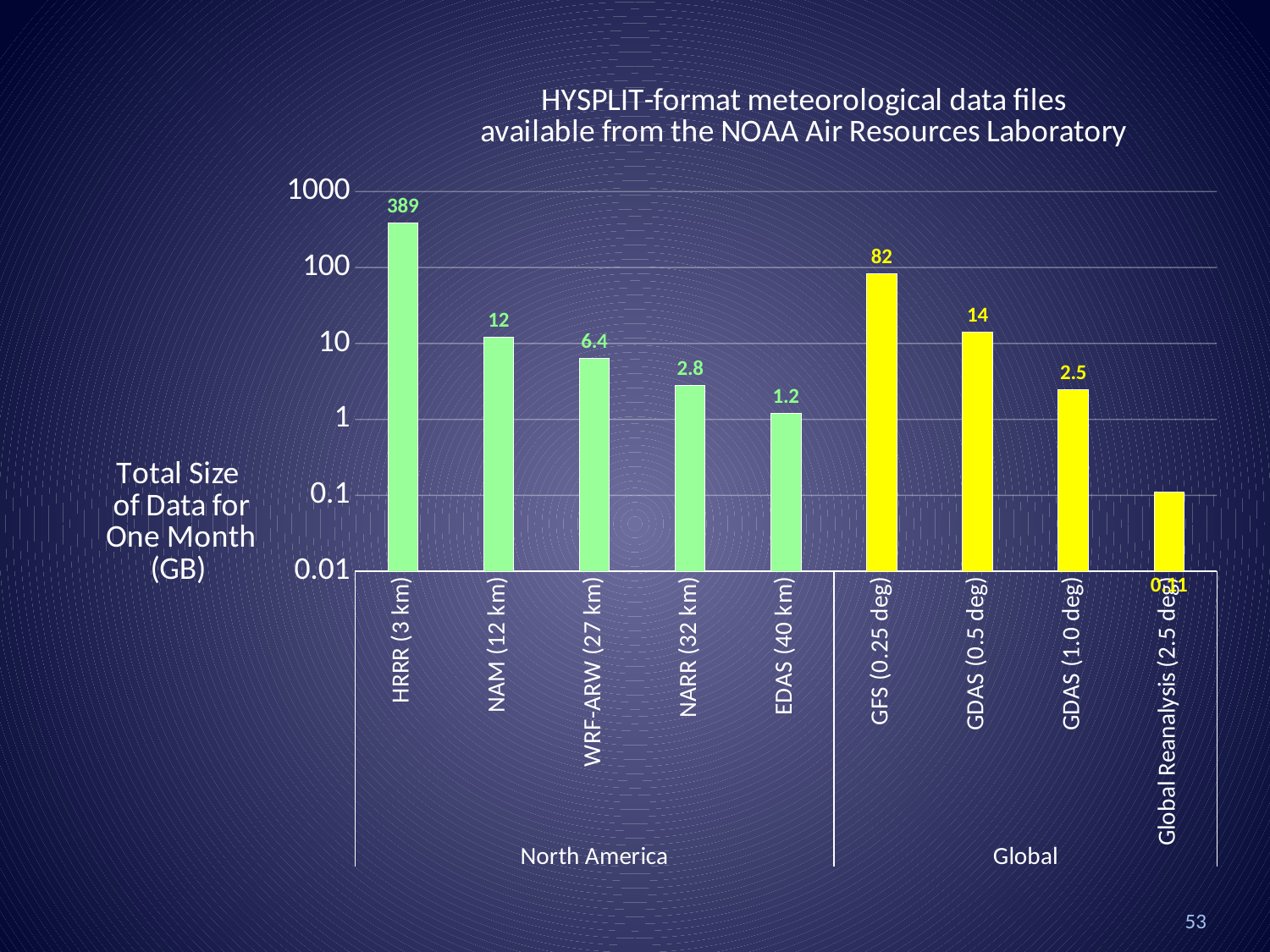
What is the value shown for GFS (0.25 deg)? 82 Is the value for Global Reanalysis (2.5 deg) greater or less than 1? less What is the value shown for WRF-ARW (27 km)? 6.4 What is the difference between the values for GDAS (0.5 deg) and NAM (12 km)? 2 Which category has the highest total size of data for one month? HRRR (3 km) What is the difference between the values for HRRR (3 km) and GFS (0.25 deg)? 307 How many categories are plotted in the chart? 9 What is the value shown for GDAS (1.0 deg)? 2.5 What kind of chart is shown on the slide? bar chart What is the total size of data for one month for HRRR (3 km)? 389 Which is larger, the value for NARR (32 km) or the value for GDAS (1.0 deg)? NARR (32 km) Which category has the lowest total size of data for one month? Global Reanalysis (2.5 deg)